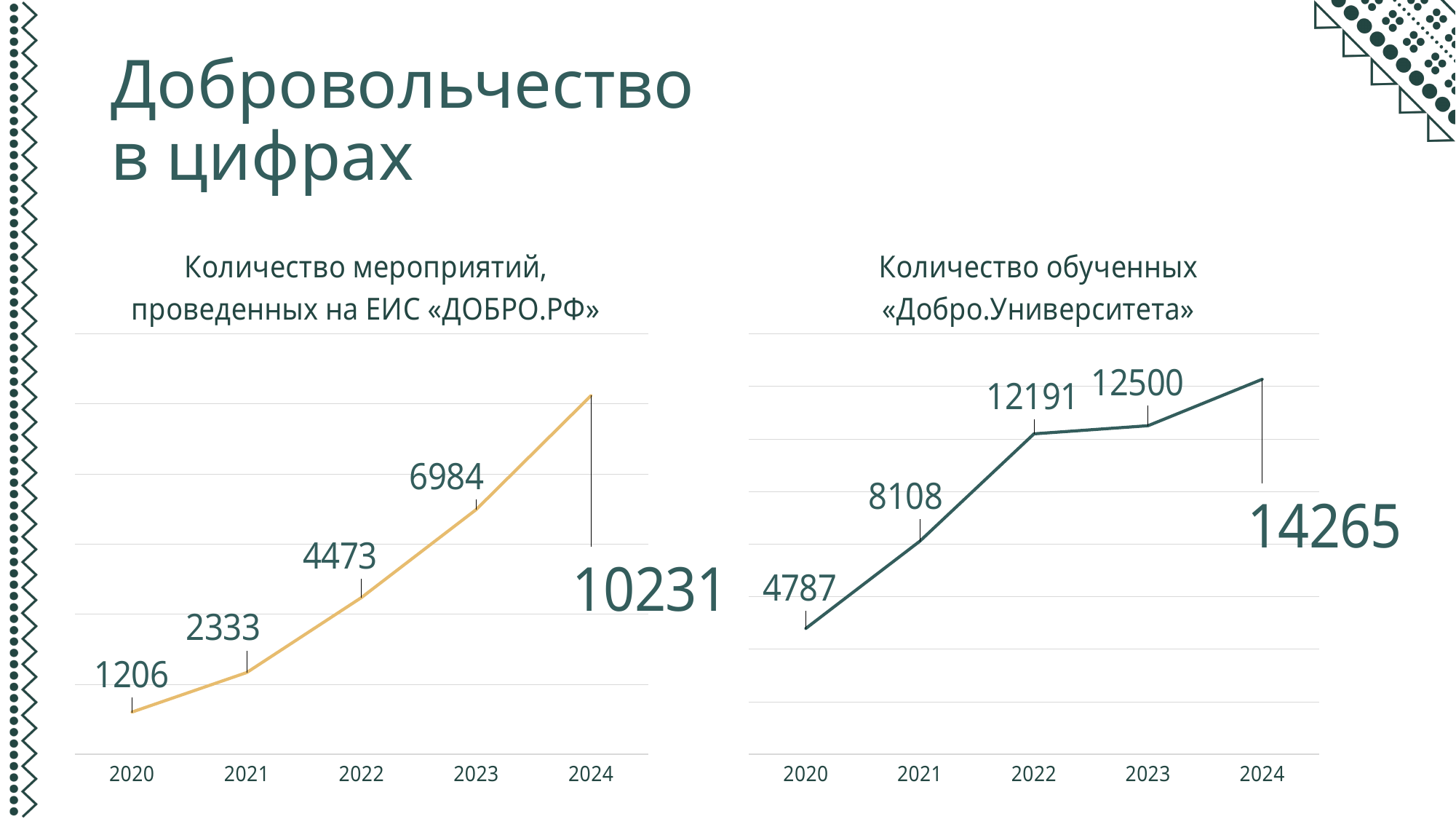
In the chart 'Количество обученных «Добро.Университета»', which is larger: the value for 2020 or the value for 2021? 2021 In the chart 'Количество обученных «Добро.Университета»', which year has the highest value? 2024 In the chart 'Количество мероприятий, проведенных на ЕИС «ДОБРО.РФ»', which year has the lowest value? 2020 In the chart 'Количество мероприятий, проведенных на ЕИС «ДОБРО.РФ»', do the values rise or fall from 2020 to 2024? rise What kind of chart is 'Количество обученных «Добро.Университета»'? line chart In the chart 'Количество мероприятий, проведенных на ЕИС «ДОБРО.РФ»', what is the value for 2024? 10231 In the chart 'Количество мероприятий, проведенных на ЕИС «ДОБРО.РФ»', what is the difference between the values for 2024 and 2023? 3247 In the chart 'Количество мероприятий, проведенных на ЕИС «ДОБРО.РФ»', what is the value for 2022? 4473 In the chart 'Количество обученных «Добро.Университета»', what is the value for 2021? 8108 How many years are plotted in the chart 'Количество мероприятий, проведенных на ЕИС «ДОБРО.РФ»'? 5 In the chart 'Количество обученных «Добро.Университета»', what is the difference between the values for 2022 and 2021? 4083 In the chart 'Количество обученных «Добро.Университета»', what is the value for 2023? 12500